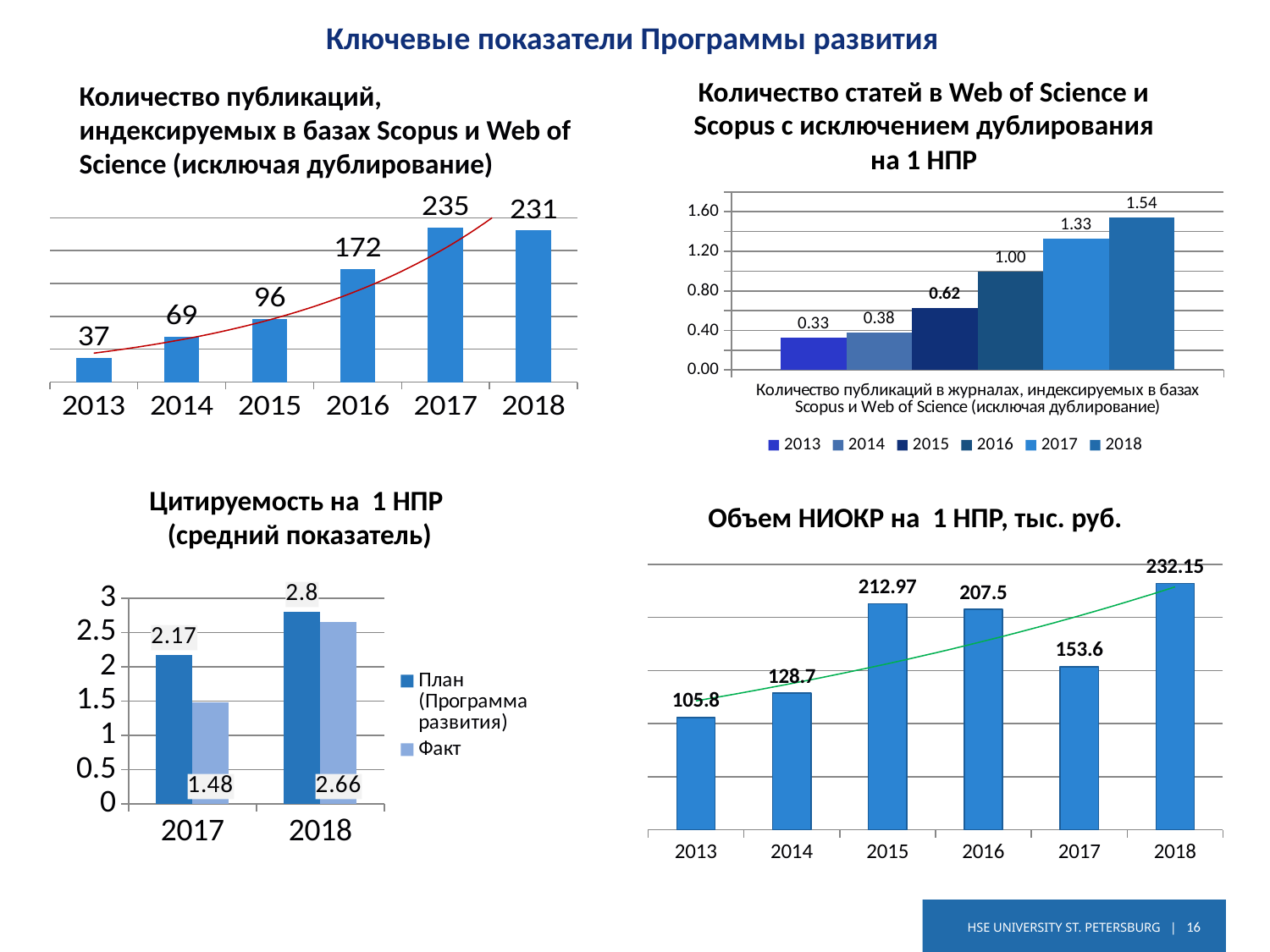
How many years are shown on the x axis of the chart 'Объем НИОКР на 1 НПР, тыс. руб.'? 6 In the chart 'Количество публикаций, индексируемых в базах Scopus и Web of Science (исключая дублирование)', which year has the highest value? 2017 In the chart 'Количество публикаций, индексируемых в базах Scopus и Web of Science (исключая дублирование)', what is the value for 2016? 172 In the chart 'Количество статей в Web of Science и Scopus с исключением дублирования на 1 НПР', what is the value for 2015? 0.62 In the chart 'Количество публикаций, индексируемых в базах Scopus и Web of Science (исключая дублирование)', what is the difference between the values for 2017 and 2018? 4 In the chart 'Объем НИОКР на 1 НПР, тыс. руб.', which year has the highest value? 2018 In the chart 'Цитируемость на 1 НПР (средний показатель)', which is larger for 2017: 'План (Программа развития)' or 'Факт'? План (Программа развития) How many entries does the legend of the chart 'Количество статей в Web of Science и Scopus с исключением дублирования на 1 НПР' list? 6 In the chart 'Объем НИОКР на 1 НПР, тыс. руб.', what is the value for 2017? 153.6 In the chart 'Количество статей в Web of Science и Scopus с исключением дублирования на 1 НПР', which year has the lowest value? 2013 In the chart 'Цитируемость на 1 НПР (средний показатель)', what is the 'Факт' value for 2017? 1.48 In the chart 'Цитируемость на 1 НПР (средний показатель)', what is the difference between the 'План' and 'Факт' values for 2018? 0.14